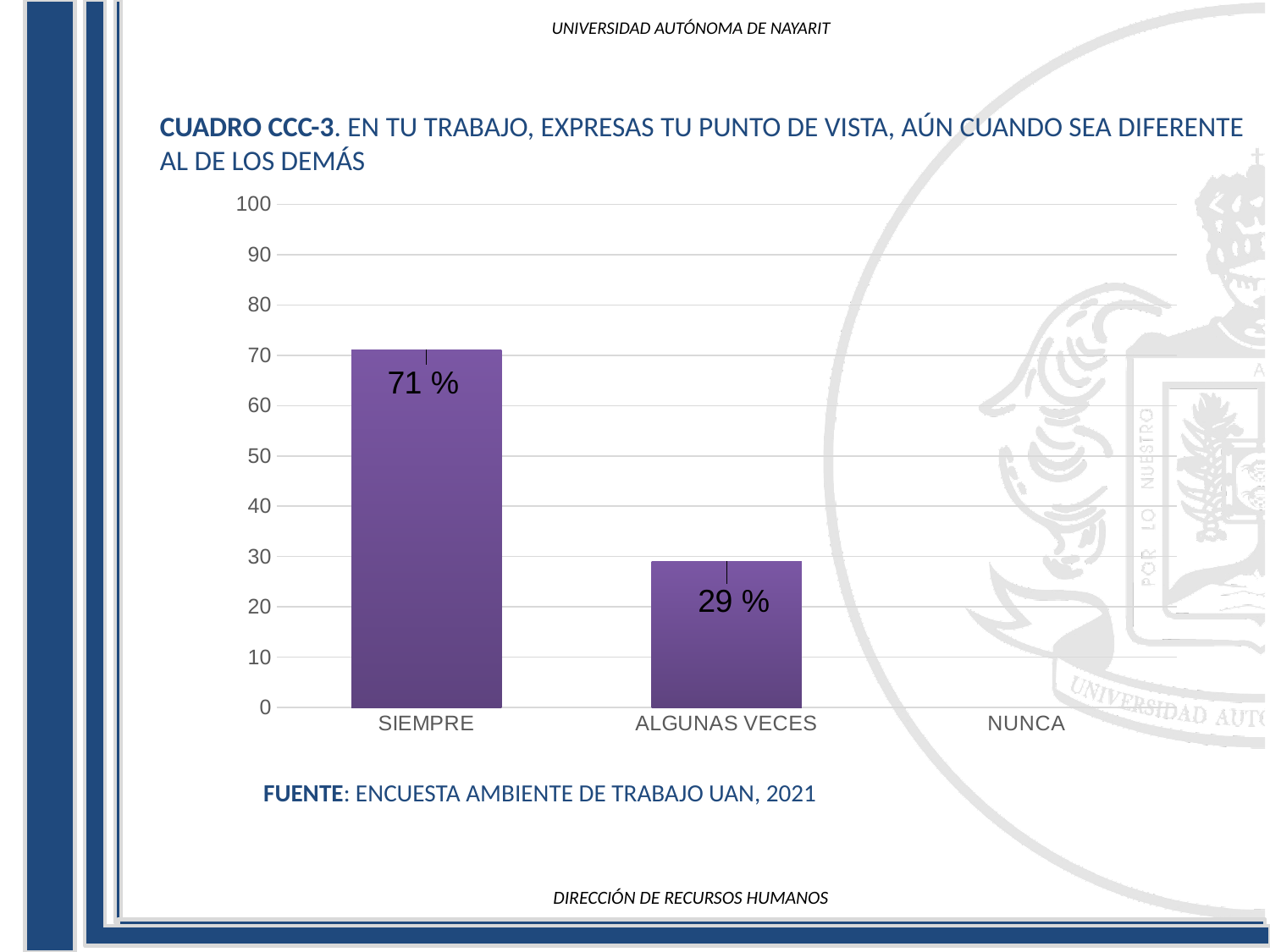
What is the code of the cuadro in the chart title? CUADRO CCC-3 How many categories are shown on the x axis? 3 Which is larger, the value for SIEMPRE or the value for ALGUNAS VECES? SIEMPRE What is the value for ALGUNAS VECES? 29 % What is the difference between the values for SIEMPRE and ALGUNAS VECES? 42 % What is the source cited below the chart? ENCUESTA AMBIENTE DE TRABAJO UAN, 2021 What is the value for SIEMPRE? 71 % Is the value for SIEMPRE greater or less than 50? greater Which category has the highest value? SIEMPRE Is the value for ALGUNAS VECES greater or less than 40? less What kind of chart is shown on the slide? bar chart